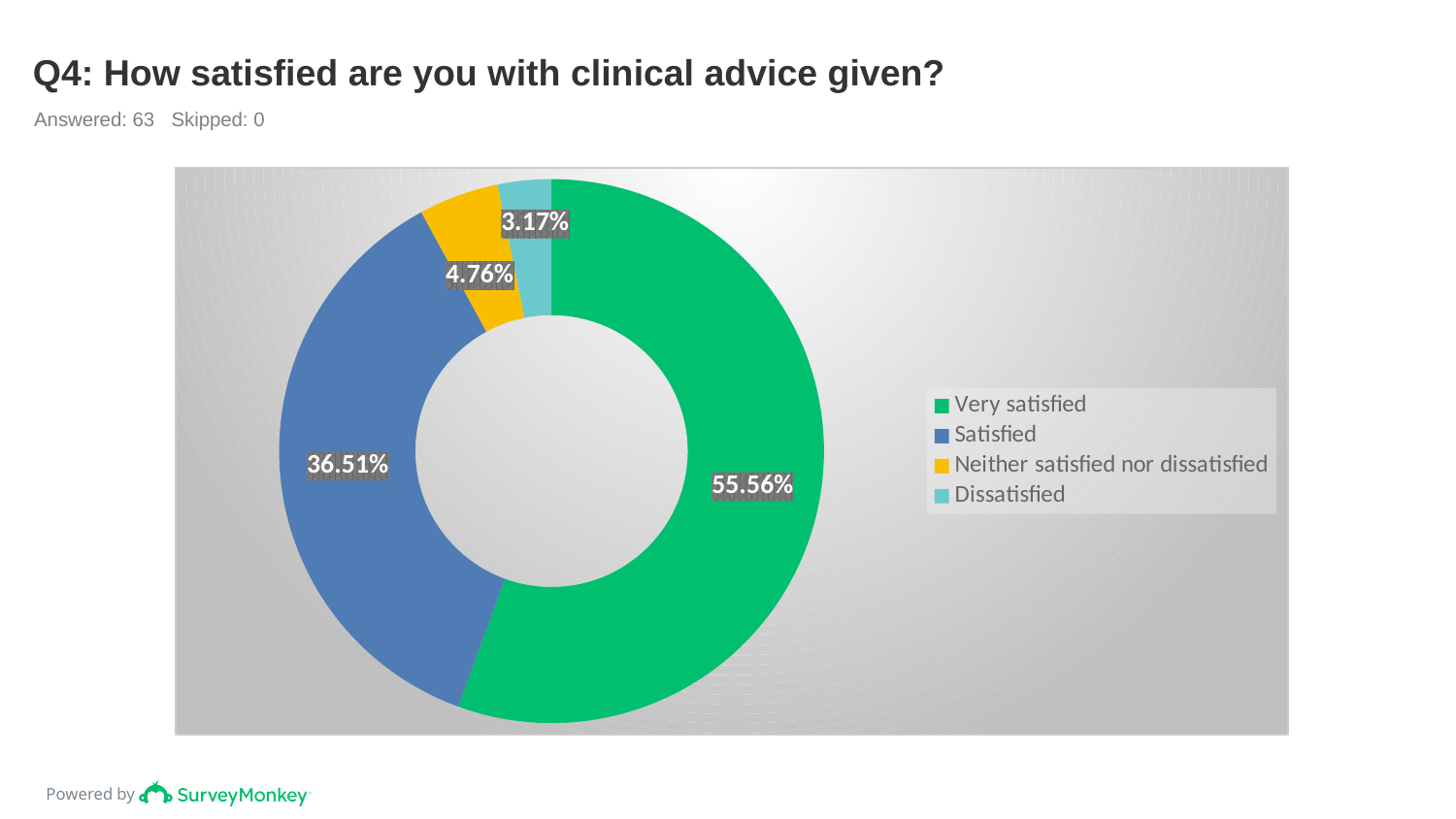
Which response category has the smallest share of the chart? Dissatisfied How many response categories are shown in the chart? 4 How many people answered this question according to the slide? 63 What percentage of respondents were Neither satisfied nor dissatisfied? 4.76% What percentage of respondents were Satisfied? 36.51% What is the difference in percentage points between Very satisfied and Satisfied? 19.05 Which is larger, the share for Neither satisfied nor dissatisfied or the share for Dissatisfied? Neither satisfied nor dissatisfied What is the title of the chart on the slide? Q4: How satisfied are you with clinical advice given? What percentage of respondents were Dissatisfied? 3.17% What kind of chart is shown on the slide? Pie chart (doughnut) What percentage of respondents were Very satisfied with the clinical advice given? 55.56% Which response category has the largest share of the chart? Very satisfied